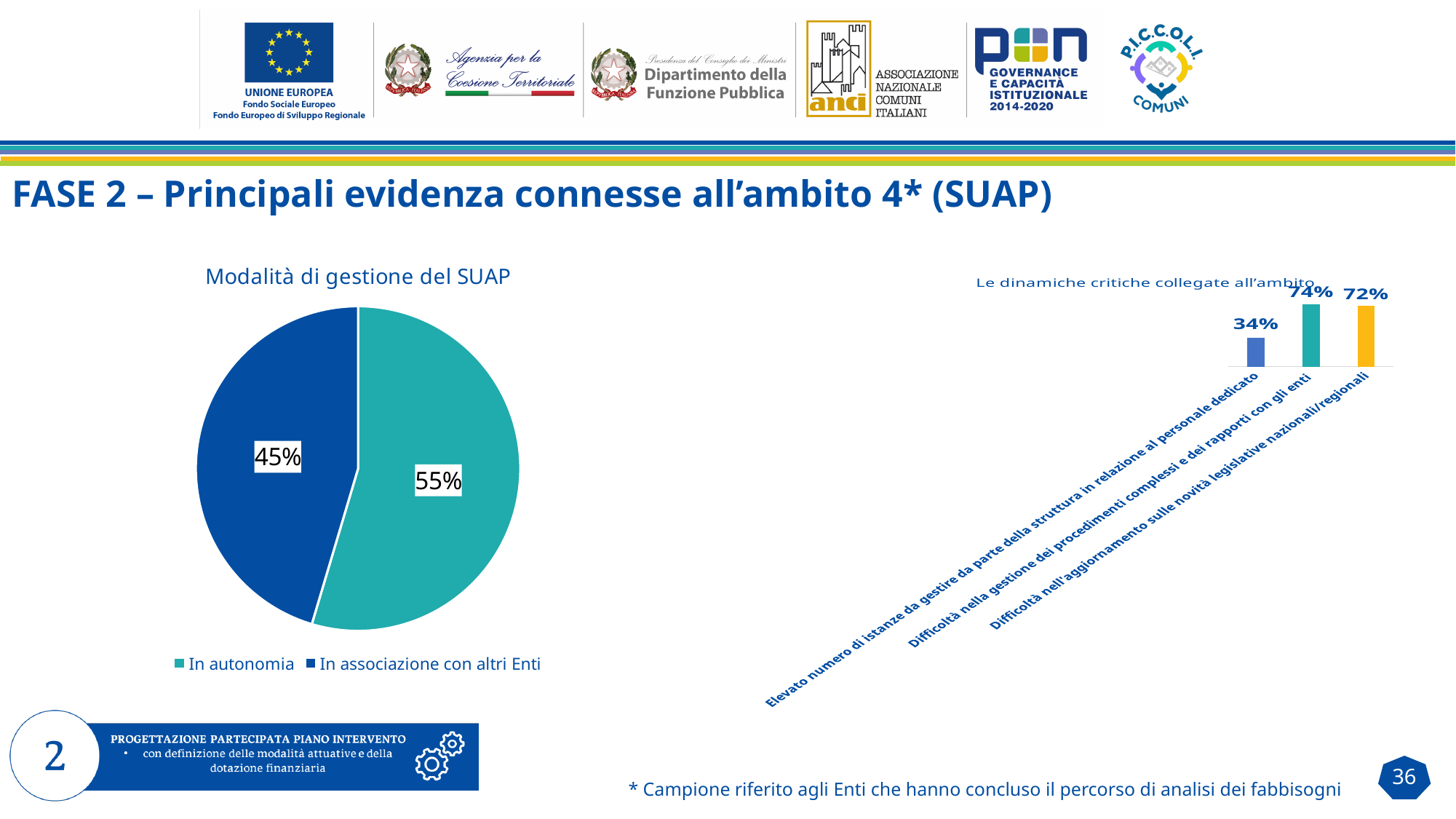
In the pie chart 'Modalità di gestione del SUAP', what is the difference in percentage points between 'In autonomia' and 'In associazione con altri Enti'? 10 percentage points In the chart 'Le dinamiche critiche collegate all'ambito', which category has the lowest value? Elevato numero di istanze da gestire da parte della struttura in relazione al personale dedicato In the chart 'Le dinamiche critiche collegate all'ambito', what is the value for 'Difficoltà nell'aggiornamento sulle novità legislative nazionali/regionali'? 72% In the chart 'Le dinamiche critiche collegate all'ambito', what is the difference between the highest and lowest values? 40 percentage points How many slices does the pie chart 'Modalità di gestione del SUAP' have? 2 In the chart 'Le dinamiche critiche collegate all'ambito', what is the value for 'Difficoltà nella gestione dei procedimenti complessi e dei rapporti con gli enti'? 74% What kind of chart is 'Modalità di gestione del SUAP'? Pie chart In the chart 'Le dinamiche critiche collegate all'ambito', what is the value for 'Elevato numero di istanze da gestire da parte della struttura in relazione al personale dedicato'? 34% In the pie chart 'Modalità di gestione del SUAP', which category has the larger share? In autonomia What kind of chart is 'Le dinamiche critiche collegate all'ambito'? Bar chart In the pie chart 'Modalità di gestione del SUAP', what share is 'In autonomia'? 55% In the pie chart 'Modalità di gestione del SUAP', what share is 'In associazione con altri Enti'? 45%